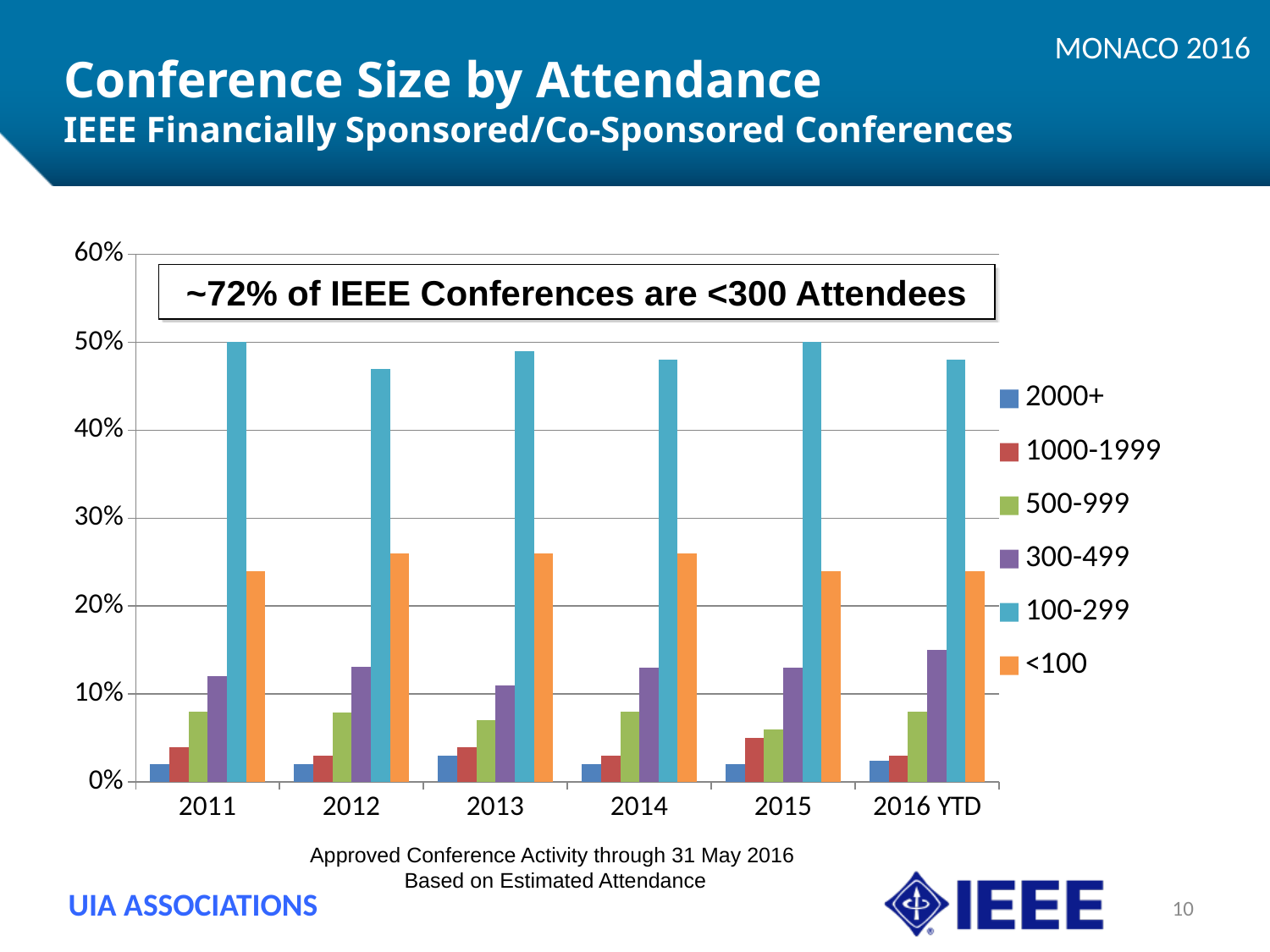
What does the text box inside the chart say? ~72% of IEEE Conferences are <300 Attendees What kind of chart is shown on the slide? bar chart Is the value for 100-299 in 2012 greater or less than 50%? less Is the value for 300-499 in 2016 YTD greater or less than 10%? greater How many year categories are shown on the x axis? 6 Which attendance range has the highest share in 2011? 100-299 Is the value for <100 in 2012 greater or less than 20%? greater Which attendance range has the lowest share in 2014? 2000+ In 2012, which is larger: the share for 500-999 or the share for 1000-1999? 500-999 In 2014, which is larger: the share for <100 or the share for 300-499? <100 How many series does the legend list? 6